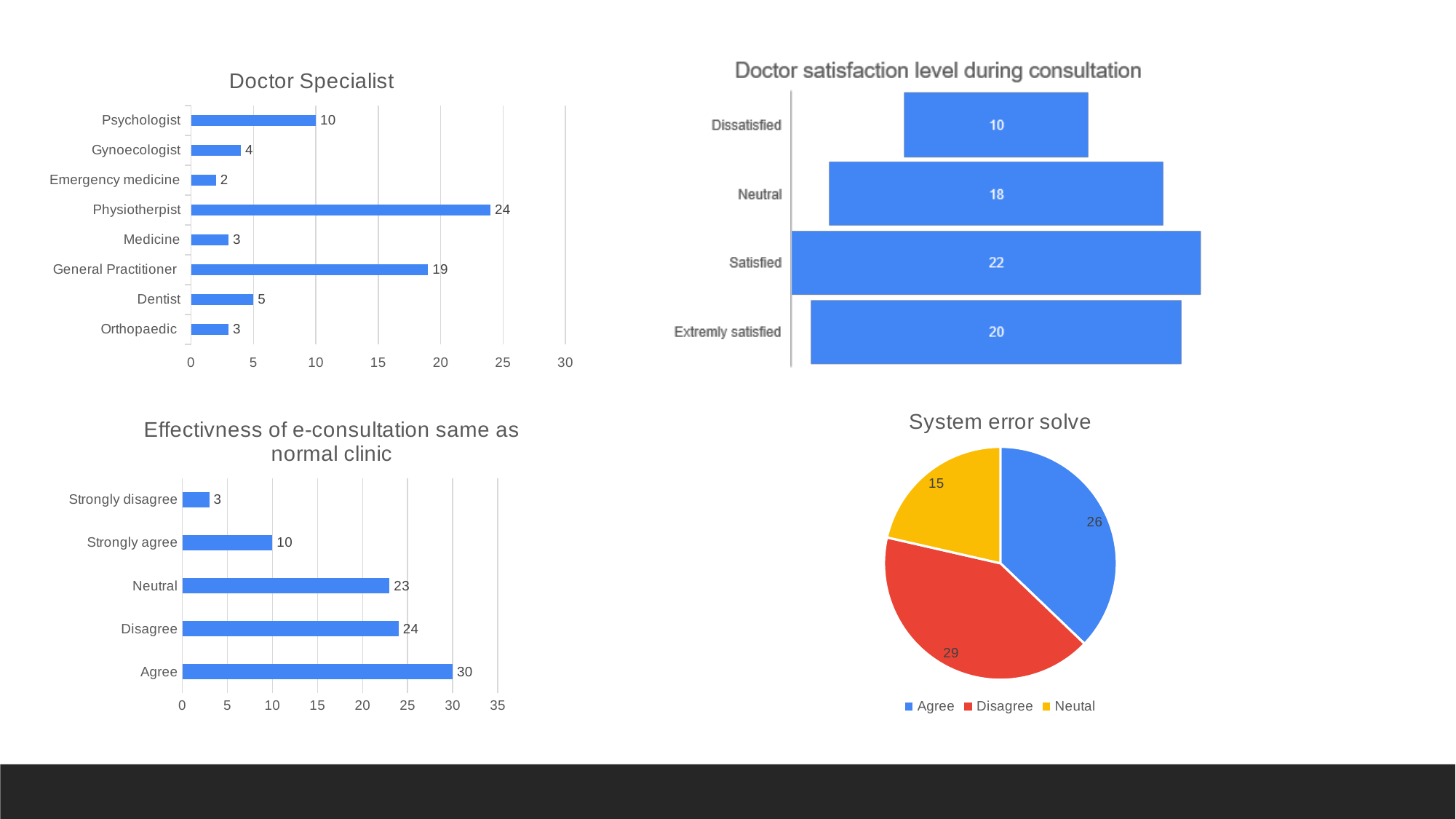
In the Doctor satisfaction level during consultation chart, which is larger, Extremly satisfied or Dissatisfied? Extremly satisfied In the Doctor satisfaction level during consultation chart, what is the value for Neutral? 18 In the Effectivness of e-consultation same as normal clinic chart, what is the difference between Disagree and Neutral? 1 In the Doctor Specialist chart, how many categories are shown? 8 In the System error solve chart, what is the value for Disagree? 29 In the Doctor Specialist chart, what is the value for Physiotherpist? 24 In the Effectivness of e-consultation same as normal clinic chart, what is the value for Agree? 30 In the Doctor Specialist chart, which category has the lowest value? Emergency medicine In the Doctor Specialist chart, what is the difference between General Practitioner and Dentist? 14 In the Doctor satisfaction level during consultation chart, which category has the highest value? Satisfied In the System error solve chart, how many entries does the legend list? 3 What kind of chart is the System error solve chart? Pie chart